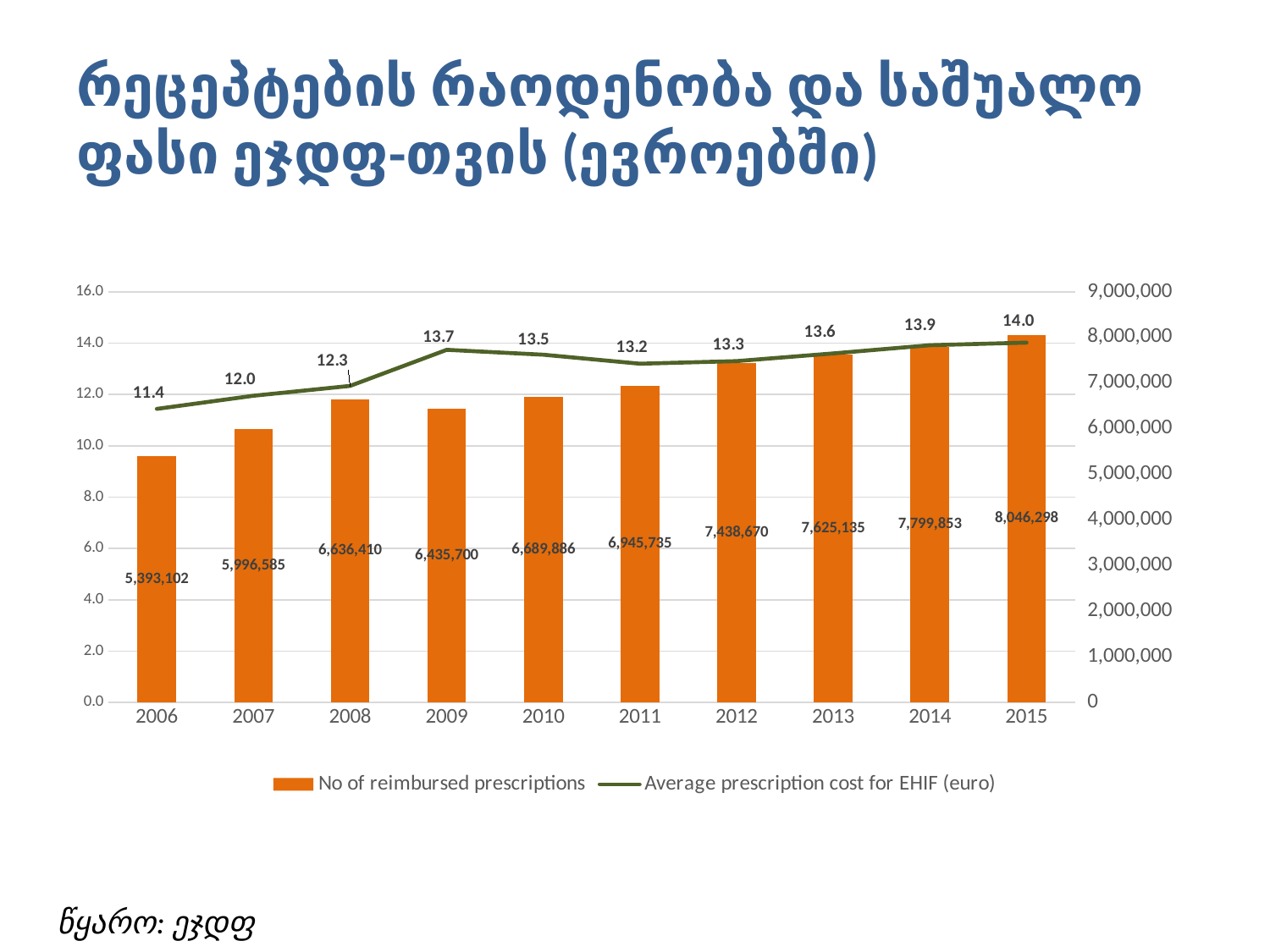
What colour are the bars for the number of reimbursed prescriptions? Orange What was the average prescription cost for EHIF (euro) in 2009? 13.7 What is the difference in the number of reimbursed prescriptions between 2015 and 2014? 246,445 How many series does the legend list? 2 Does the number of reimbursed prescriptions rise or fall from 2012 to 2015? rise What is the number of reimbursed prescriptions in 2015? 8,046,298 Is the number of reimbursed prescriptions in 2012 greater or less than 7,000,000? greater Which year had more reimbursed prescriptions, 2008 or 2009? 2008 Which year has the lowest average prescription cost for EHIF (euro)? 2006 How many years are shown on the x axis of the chart? 10 What is the number of reimbursed prescriptions in 2006? 5,393,102 Which year has the highest number of reimbursed prescriptions? 2015